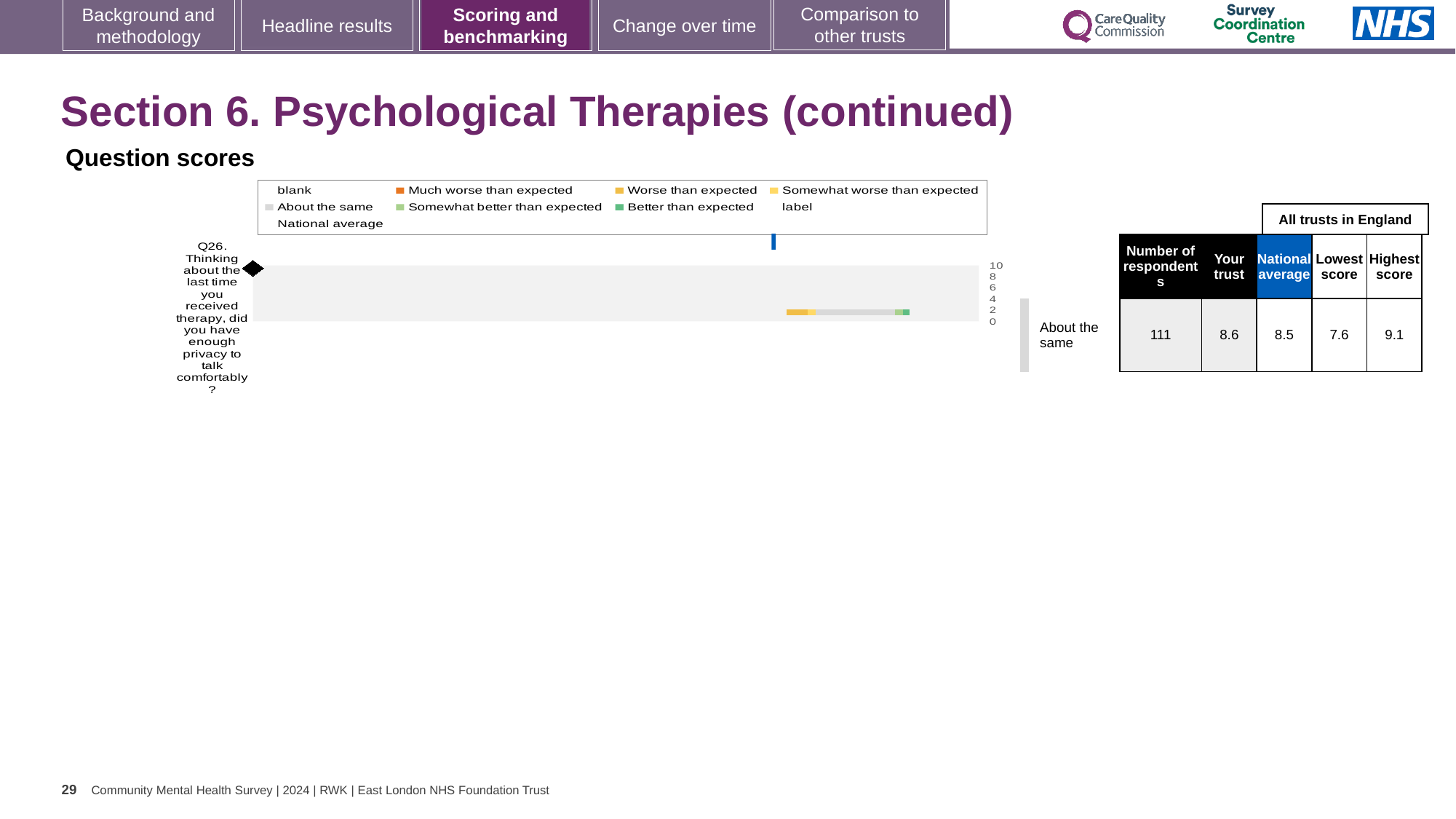
How many respondents answered Q26? 111 What is the national average score for Q26? 8.5 What kind of chart is used to show the Q26 question score? bar chart How many survey questions are plotted on the chart? 1 What is the difference between the highest score and the lowest score for Q26? 1.5 Which question number is plotted on the chart? Q26 What is the difference between the 'Your trust' score and the national average for Q26? 0.1 What is the lowest score among all trusts in England for Q26? 7.6 What benchmarking category is the trust's Q26 score placed in? About the same What is the 'Your trust' score for Q26? 8.6 Which is larger for Q26, the 'Your trust' score or the national average? Your trust What is the highest score among all trusts in England for Q26? 9.1